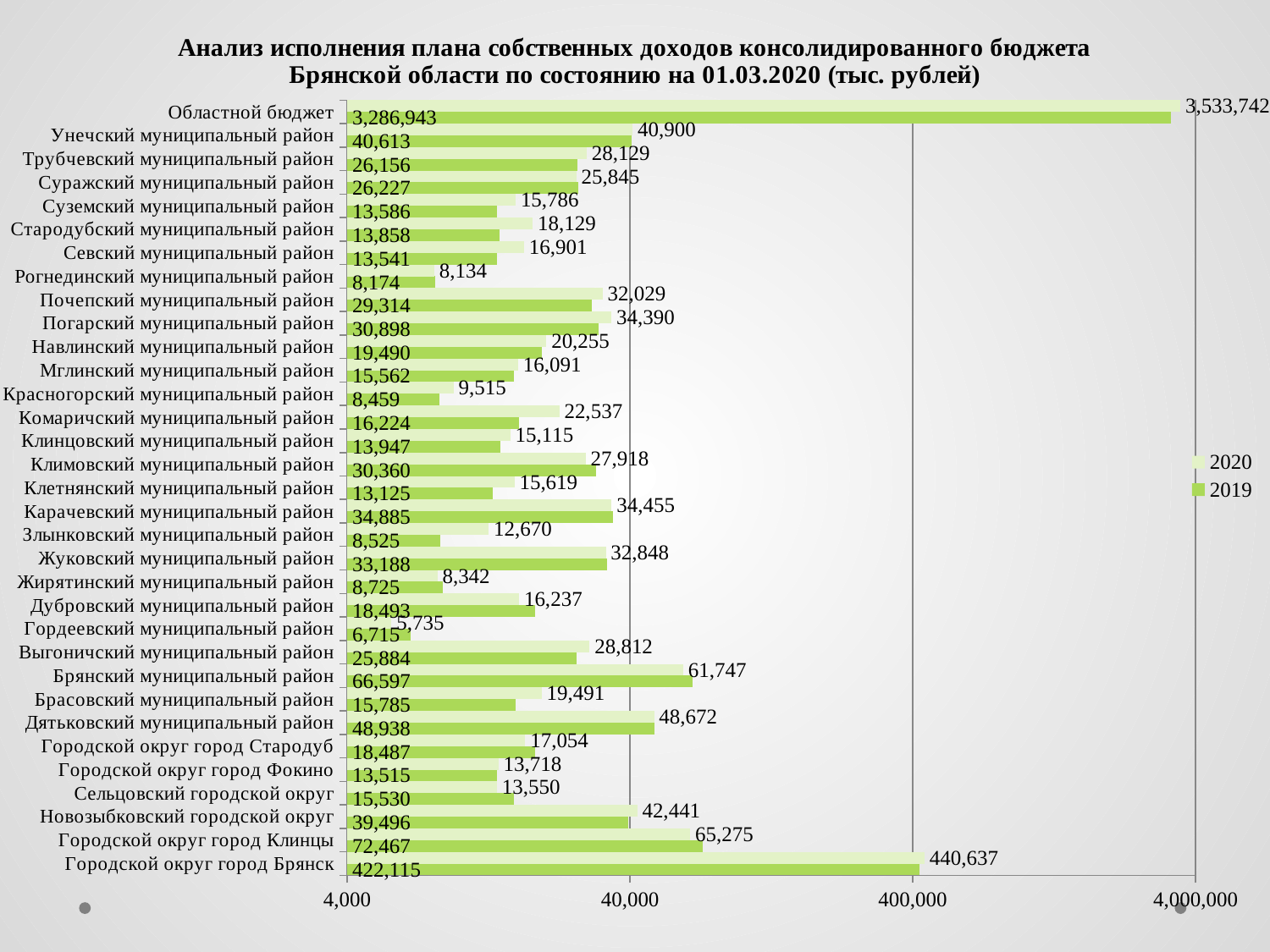
How many categories are shown on the chart? 33 What kind of chart is shown on the slide? Bar chart Which category has the highest 2020 value? Областной бюджет Which is larger for Климовский муниципальный район, the 2020 value or the 2019 value? 2019 What is the 2019 value for Областной бюджет? 3,286,943 Which series is shown in the lighter green colour? 2020 What is the 2020 value for Городской округ город Брянск? 440,637 What is the difference between the 2020 and 2019 values for Комаричский муниципальный район? 6,313 How many series does the legend list? 2 What is the 2019 value for Городской округ город Клинцы? 72,467 What is the 2020 value for Брянский муниципальный район? 61,747 Which category has the lowest 2020 value? Гордеевский муниципальный район